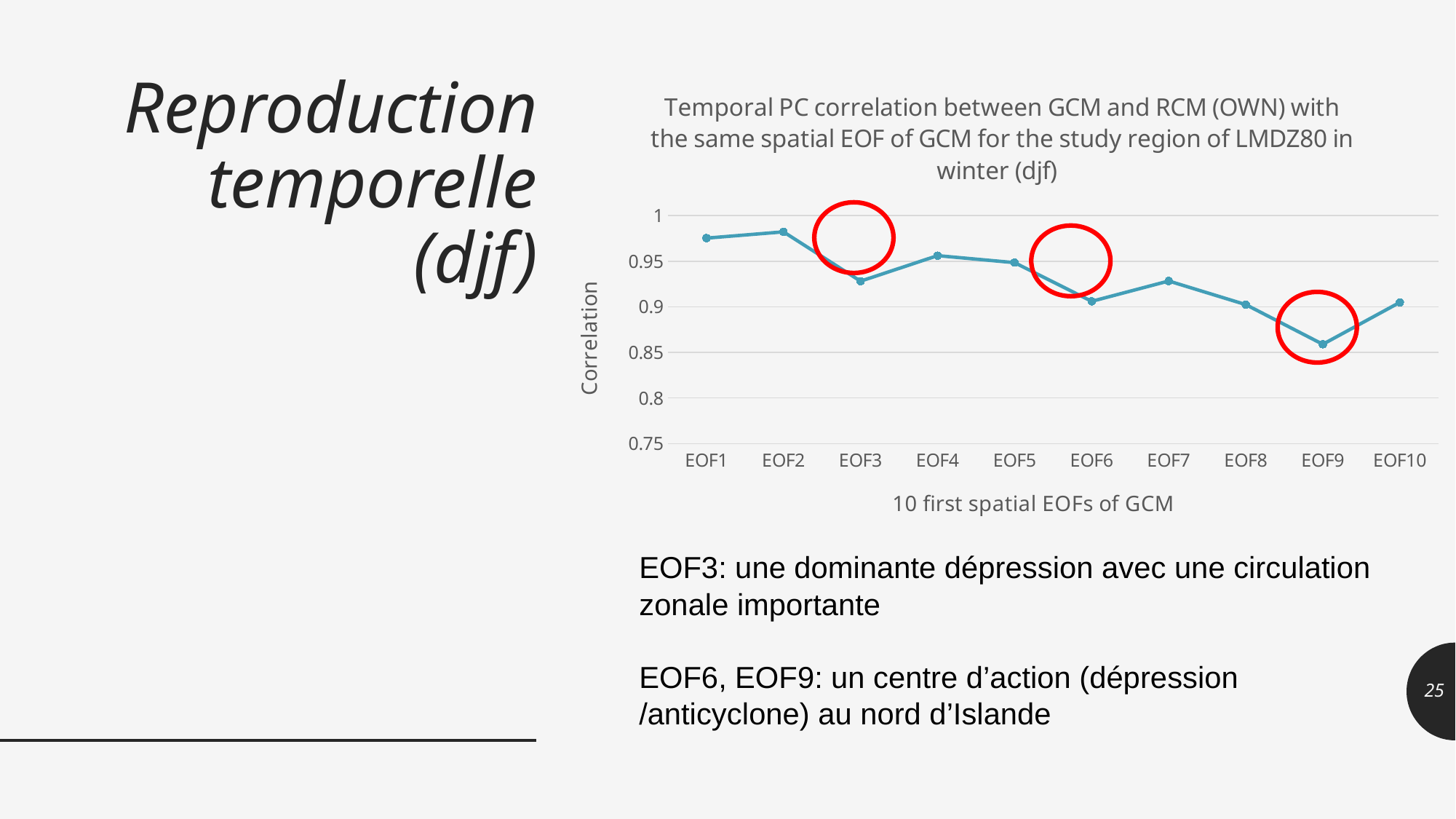
Is the correlation value for EOF3 greater or less than 0.95? less Overall, does the correlation rise or fall from EOF1 to EOF10? Fall Is the correlation value for EOF10 greater or less than 0.85? greater What is the title of the vertical axis of the chart? Correlation What kind of chart is shown on the slide? Line chart Which EOF has the lowest correlation value? EOF9 Is the correlation value for EOF9 greater or less than 0.9? less How many EOF categories are plotted along the x axis? 10 Which has the higher correlation, EOF3 or EOF9? EOF3 Which has the higher correlation, EOF4 or EOF6? EOF4